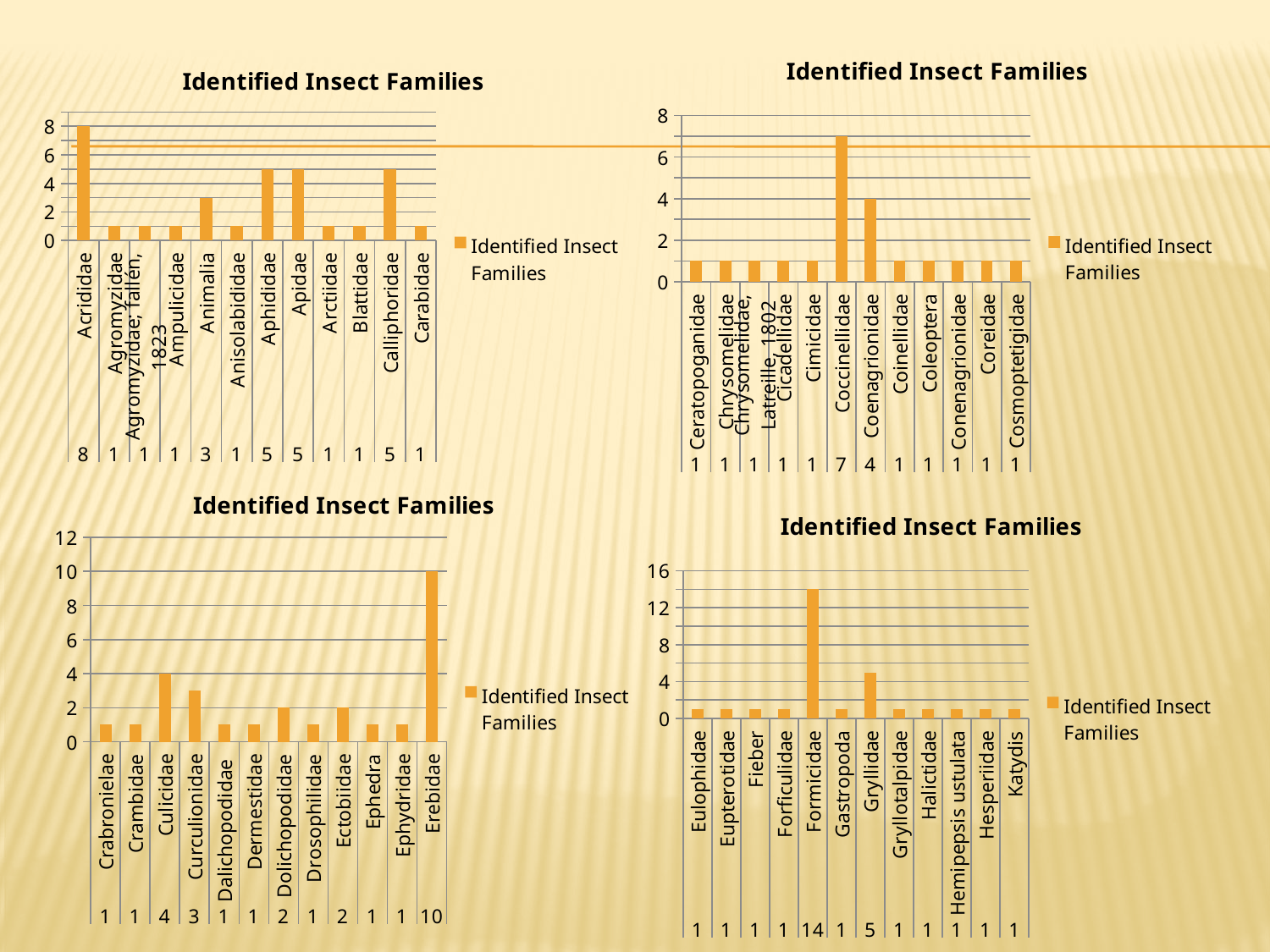
In the bottom-right chart, is the value for Gryllidae greater or less than 8? less What type of chart is the bottom-right chart? Bar chart In the top-left chart, which category has the highest value? Acrididae In the bottom-left chart, what is the value for Culicidae? 4 In the bottom-left chart, which category has the highest value? Erebidae In the top-right chart, how many categories are shown on the x axis? 12 In the top-right chart, what is the value for Coccinellidae? 7 In the bottom-right chart, what is the value for Formicidae? 14 In the top-right chart, which is larger, the value for Coccinellidae or the value for Coenagrionidae? Coccinellidae In the top-left chart, what is the difference between the values for Acrididae and Animalia? 5 In the bottom-left chart, what is the difference between the values for Erebidae and Curculionidae? 7 In the top-left chart, what is the value for Acrididae? 8